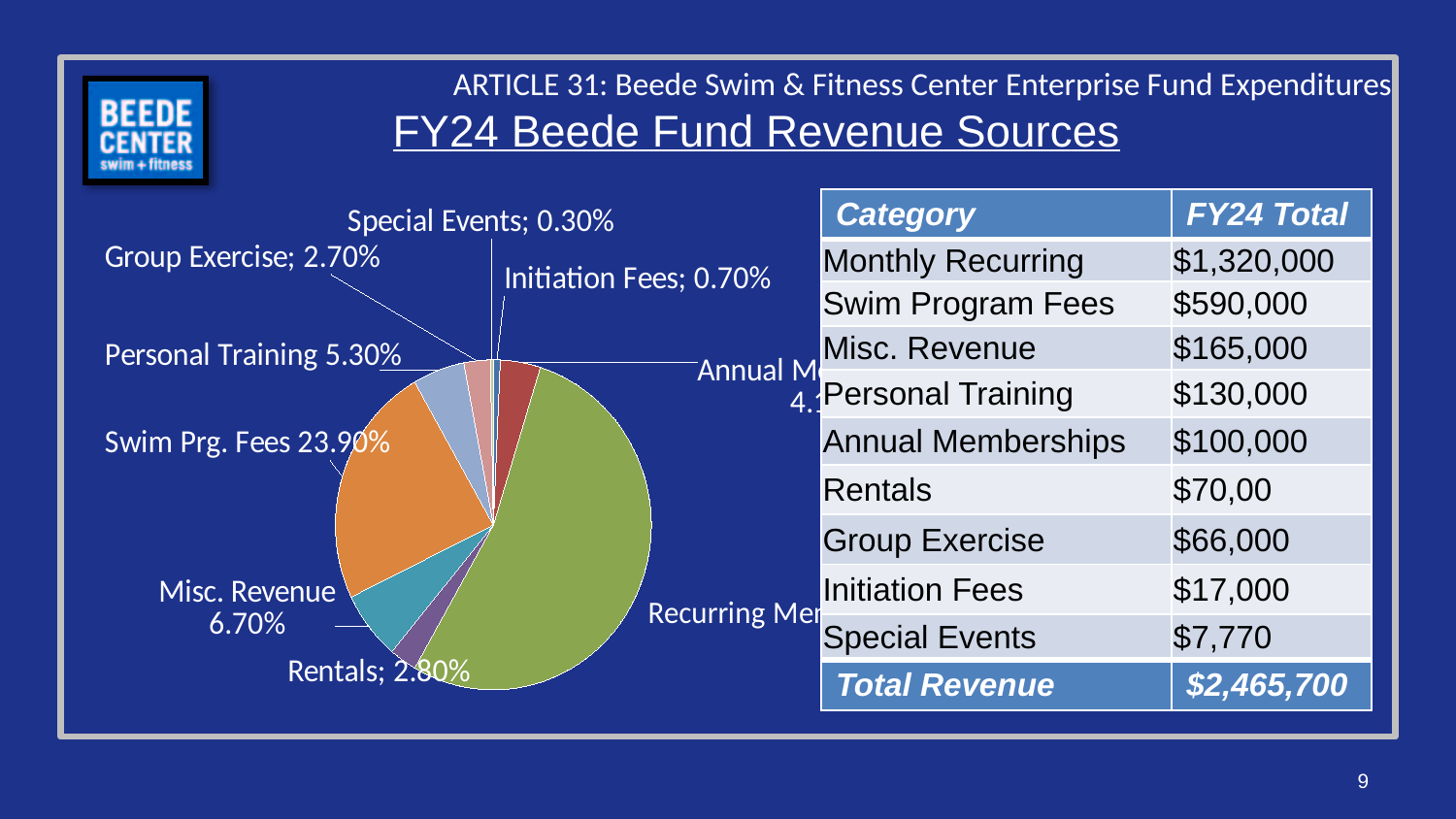
What share of the pie is Initiation Fees? 0.70% Which is larger, the slice for Swim Prg. Fees or the slice for Misc. Revenue? Swim Prg. Fees What kind of chart is shown on the slide? pie chart What share of the pie is Swim Prg. Fees? 23.90% What share of the pie is Personal Training? 5.30% What share of the pie is Rentals? 2.80% What is the title of the chart? FY24 Beede Fund Revenue Sources What share of the pie is Group Exercise? 2.70% What is the difference in percentage points between Swim Prg. Fees and Misc. Revenue? 17.20% Which category has the smallest slice of the pie? Special Events What is the difference in percentage points between Personal Training and Group Exercise? 2.60% What share of the pie is Misc. Revenue? 6.70%